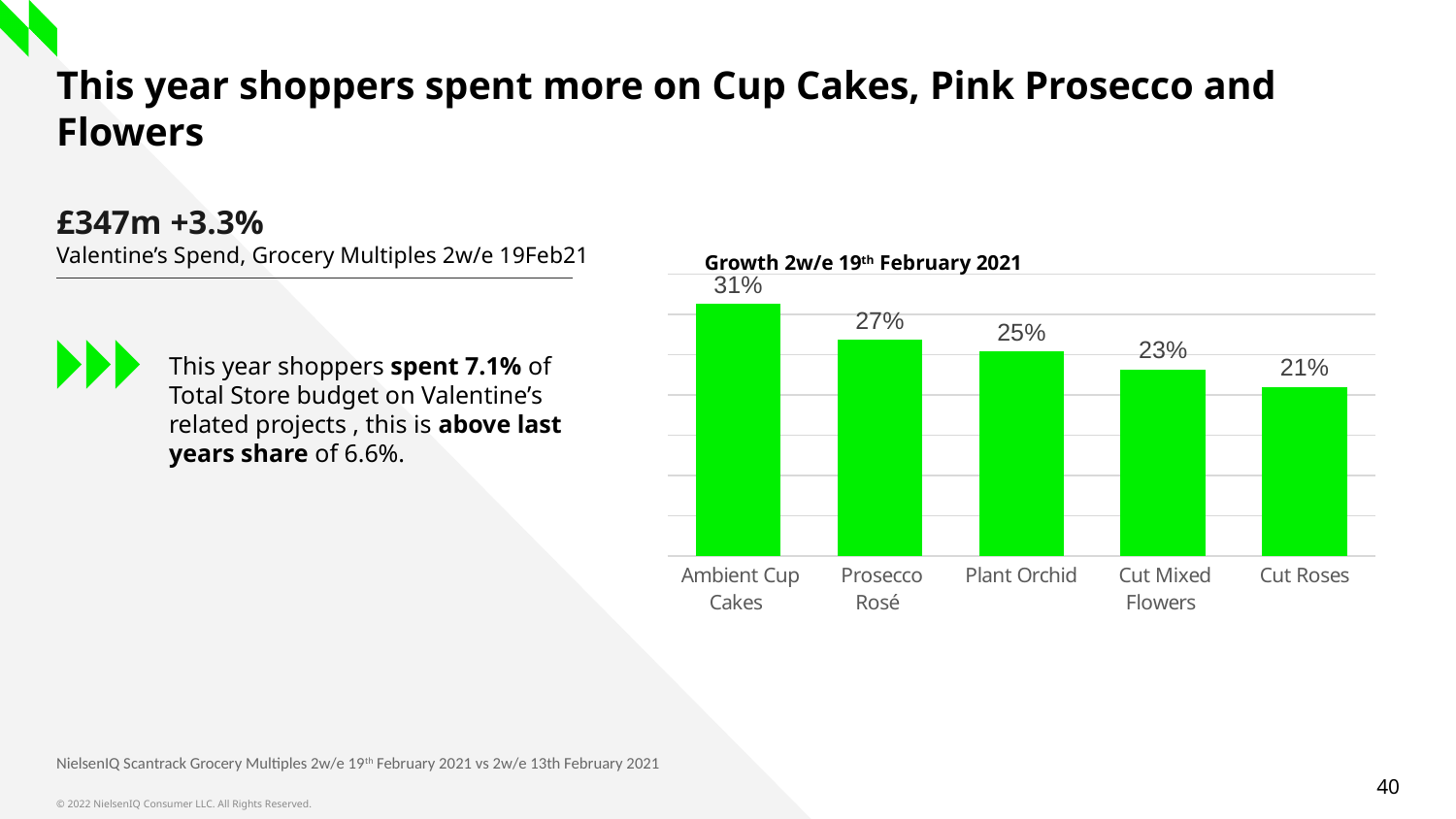
What is the title of the chart? Growth 2w/e 19th February 2021 Which has higher growth, Prosecco Rosé or Plant Orchid? Prosecco Rosé What is the growth value for Cut Roses? 21% What is the difference in growth between Ambient Cup Cakes and Cut Roses? 10% What kind of chart is shown on the slide? Bar chart What is the growth value for Cut Mixed Flowers? 23% What is the growth value for Ambient Cup Cakes? 31% What is the growth value for Plant Orchid? 25% What is the growth value for Prosecco Rosé? 27% How many categories are shown in the chart? 5 Which category has the highest growth? Ambient Cup Cakes Which category has the lowest growth? Cut Roses